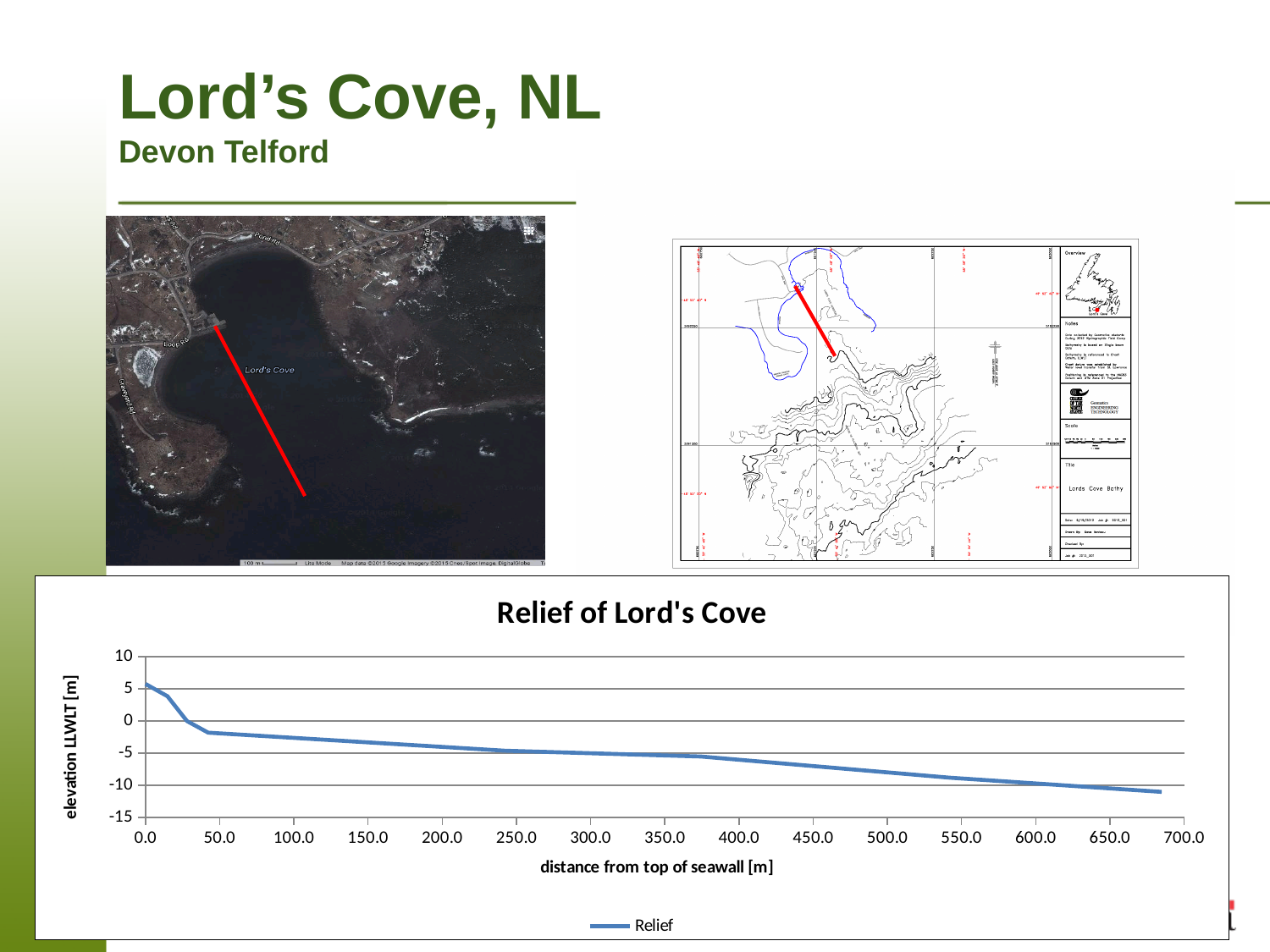
At which distance from the top of the seawall is the elevation highest in the 'Relief of Lord's Cove' chart? 0.0 In the 'Relief of Lord's Cove' chart, is the elevation at a distance of 500.0 m greater or less than -5? less What is the label of the x axis on the 'Relief of Lord's Cove' chart? distance from top of seawall [m] What is the name of the series shown in the legend of the 'Relief of Lord's Cove' chart? Relief In the 'Relief of Lord's Cove' chart, is the elevation at a distance of 500.0 m greater or less than -10? greater Does the elevation in the 'Relief of Lord's Cove' chart rise or fall as the distance from the top of the seawall increases? fall What kind of chart is 'Relief of Lord's Cove'? line chart In the 'Relief of Lord's Cove' chart, is the elevation at a distance of 100.0 m larger or smaller than the elevation at 400.0 m? larger In the 'Relief of Lord's Cove' chart, is the elevation at a distance of 0.0 m greater or less than 0? greater How many series does the legend of the 'Relief of Lord's Cove' chart list? 1